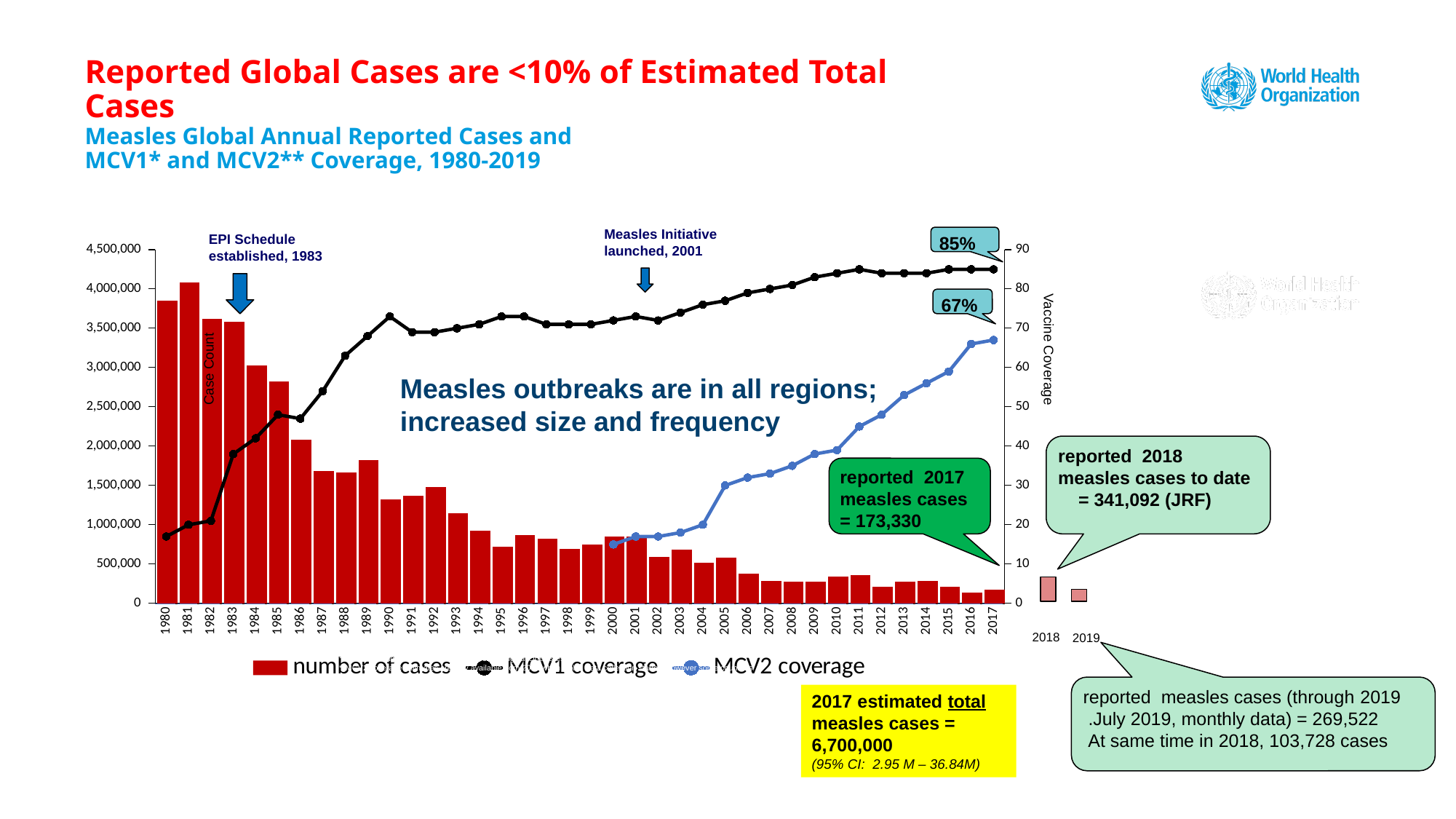
Is the MCV2 coverage in 2000 greater or less than 20? less What is the difference between MCV1 coverage and MCV2 coverage in 2017? 18 percentage points Does MCV1 coverage rise or fall from 1980 to 2017? Rise In 2017, which is larger: MCV1 coverage or MCV2 coverage? MCV1 coverage What was the MCV2 coverage in 2017 according to the callout label? 67% How many years are shown on the x axis of the main chart? 38 What kind of chart is shown on the slide? Combined bar and line chart How many reported measles cases were there in 2017? 173,330 Which year has the highest number of reported cases? 1981 Is the number of cases in 1980 greater or less than 3,500,000? greater What was the MCV1 coverage in 2017 according to the callout label? 85% How many series does the chart legend list? 3